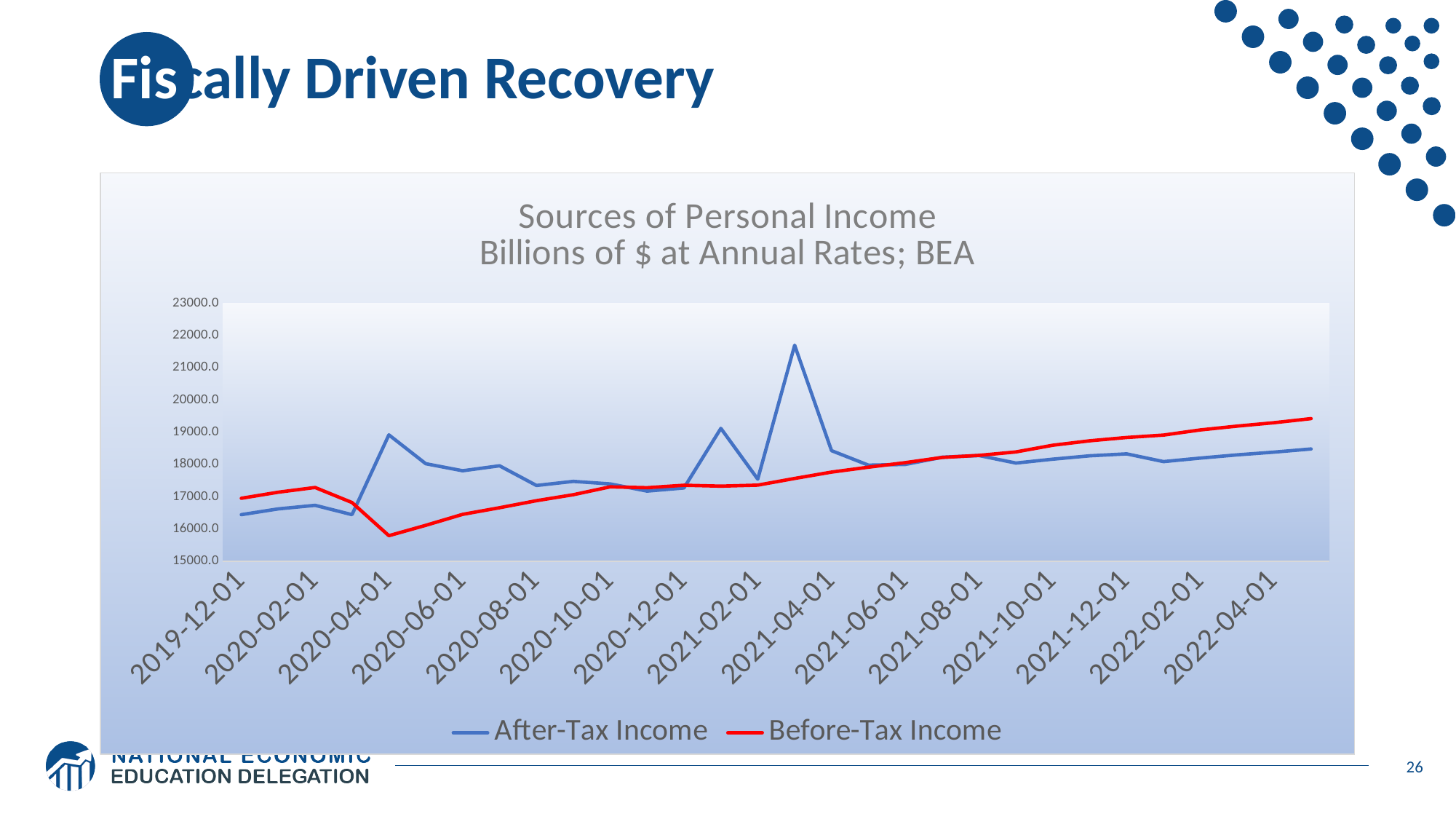
Is the value for After-Tax Income at 2019-12-01 greater or less than 17000.0? less At 2020-04-01, which series has the higher value, After-Tax Income or Before-Tax Income? After-Tax Income At which labelled date does Before-Tax Income reach its lowest value? 2020-04-01 Is the value for Before-Tax Income at 2020-04-01 greater or less than 16000.0? less Is the highest value reached by After-Tax Income greater or less than 21000.0? greater How many date labels are shown on the x axis? 15 What kind of chart is shown on the slide? Line chart What is the title of the chart? Sources of Personal Income Billions of $ at Annual Rates; BEA Which colour is used for the Before-Tax Income line? Red How many series does the legend list? 2 At 2022-04-01, which series has the higher value, After-Tax Income or Before-Tax Income? Before-Tax Income